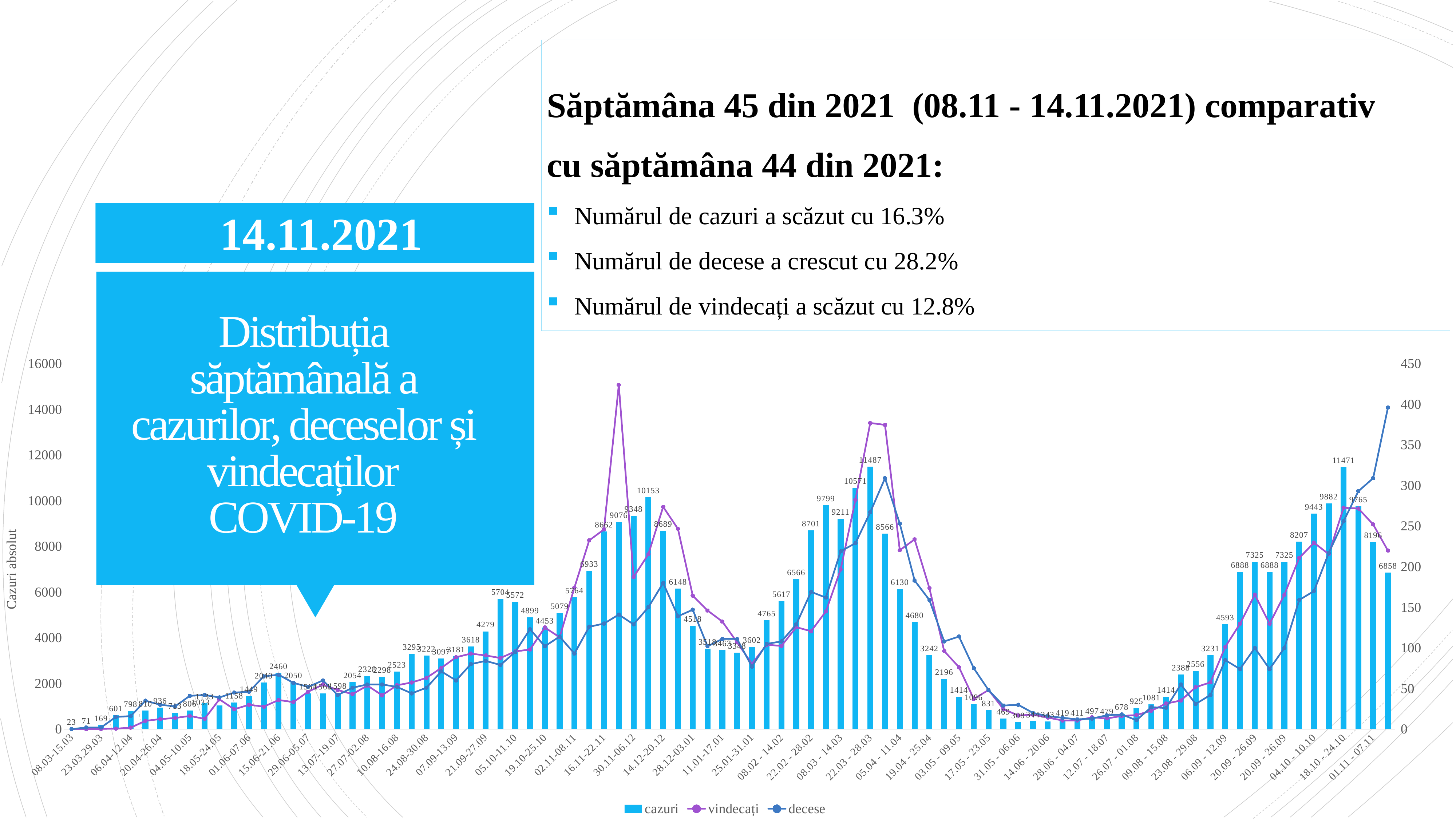
What is the number of cazuri for the week 01.11 - 07.11? 8196 Which week has the highest number of cazuri? 22.03 - 28.03 What is the number of cazuri for the week 22.03 - 28.03? 11487 Which series are listed in the chart legend? cazuri, vindecați, decese Is the value of decese for the last week on the chart greater or less than 350 on the right axis? greater Which week has the lowest number of cazuri? 08.03-15.03 What kind of chart is shown on the slide? A combined bar and line chart What is the difference in cazuri between the week 22.03 - 28.03 and the week 18.10 - 24.10? 16 How many series does the chart legend list? 3 What is the number of cazuri for the first week, 08.03-15.03? 23 What is the title of the left vertical axis? Cazuri absolut What is the number of cazuri for the week 18.10 - 24.10? 11471